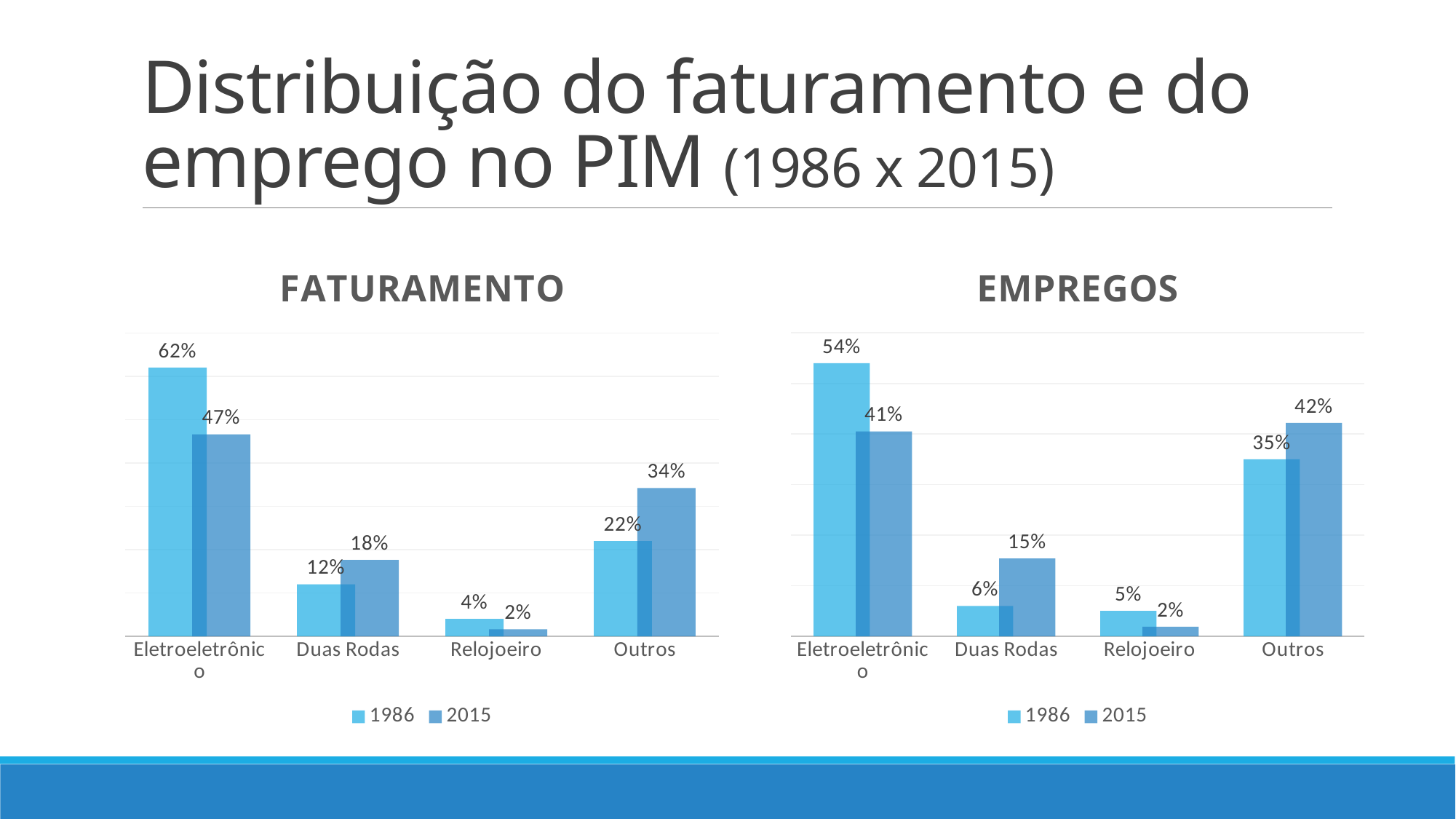
In the EMPREGOS chart, what is the value for Relojoeiro in 1986? 5% In the EMPREGOS chart, which category has the highest value for 2015? Outros In the FATURAMENTO chart, what is the value for Eletroeletrônico in 1986? 62% In the FATURAMENTO chart, what is the value for Outros in 2015? 34% In the FATURAMENTO chart, which category has the lowest value for 2015? Relojoeiro How many categories are shown on the x axis of the FATURAMENTO chart? 4 In the EMPREGOS chart, what is the value for Duas Rodas in 2015? 15% In the EMPREGOS chart, which is larger for Eletroeletrônico: the 1986 value or the 2015 value? 1986 How many series does the legend of the EMPREGOS chart list? 2 What kind of chart is the FATURAMENTO chart? Bar chart In the EMPREGOS chart, what is the difference between the 2015 and 1986 values for Outros? 7% In the FATURAMENTO chart, what is the difference between the 1986 and 2015 values for Eletroeletrônico? 15%